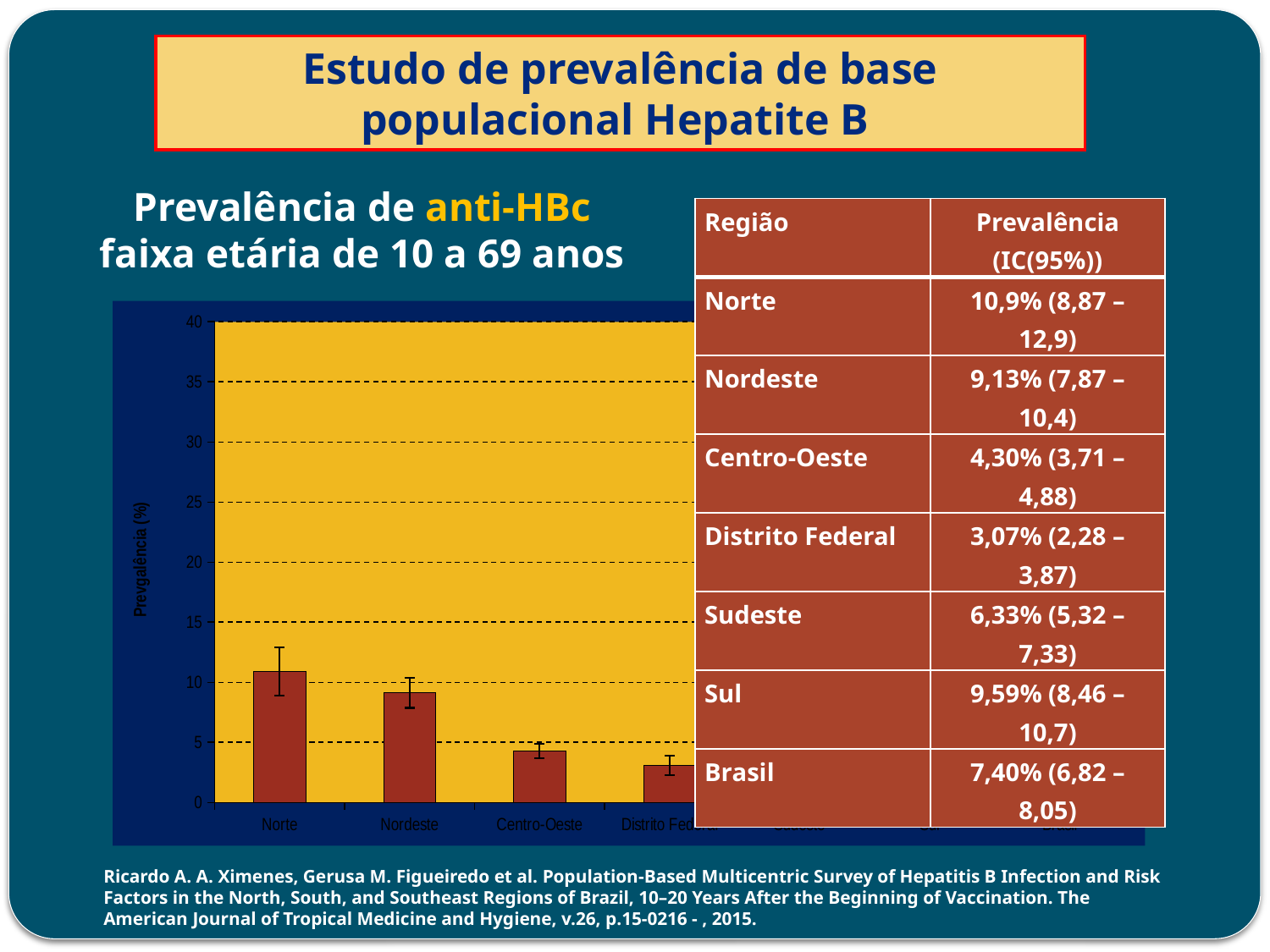
Is the bar for Distrito Federal greater or less than 5? less Is the bar for Nordeste greater or less than 5? greater What is the label of the y axis of the chart? Prevgalência (%) What kind of chart is shown on the slide? bar chart Which bar is taller, Norte or Nordeste? Norte Among the bars visible on the chart, which region has the tallest bar? Norte According to the table on the slide, what is the anti-HBc prevalence for Norte? 10,9% Among the bars visible on the chart, which region has the shortest bar? Distrito Federal Which bar is taller, Centro-Oeste or Distrito Federal? Centro-Oeste Do the bars rise or fall going from Norte to Distrito Federal along the x axis? fall What is the highest value shown on the y axis of the chart? 40 Is the bar for Norte greater or less than 15? less